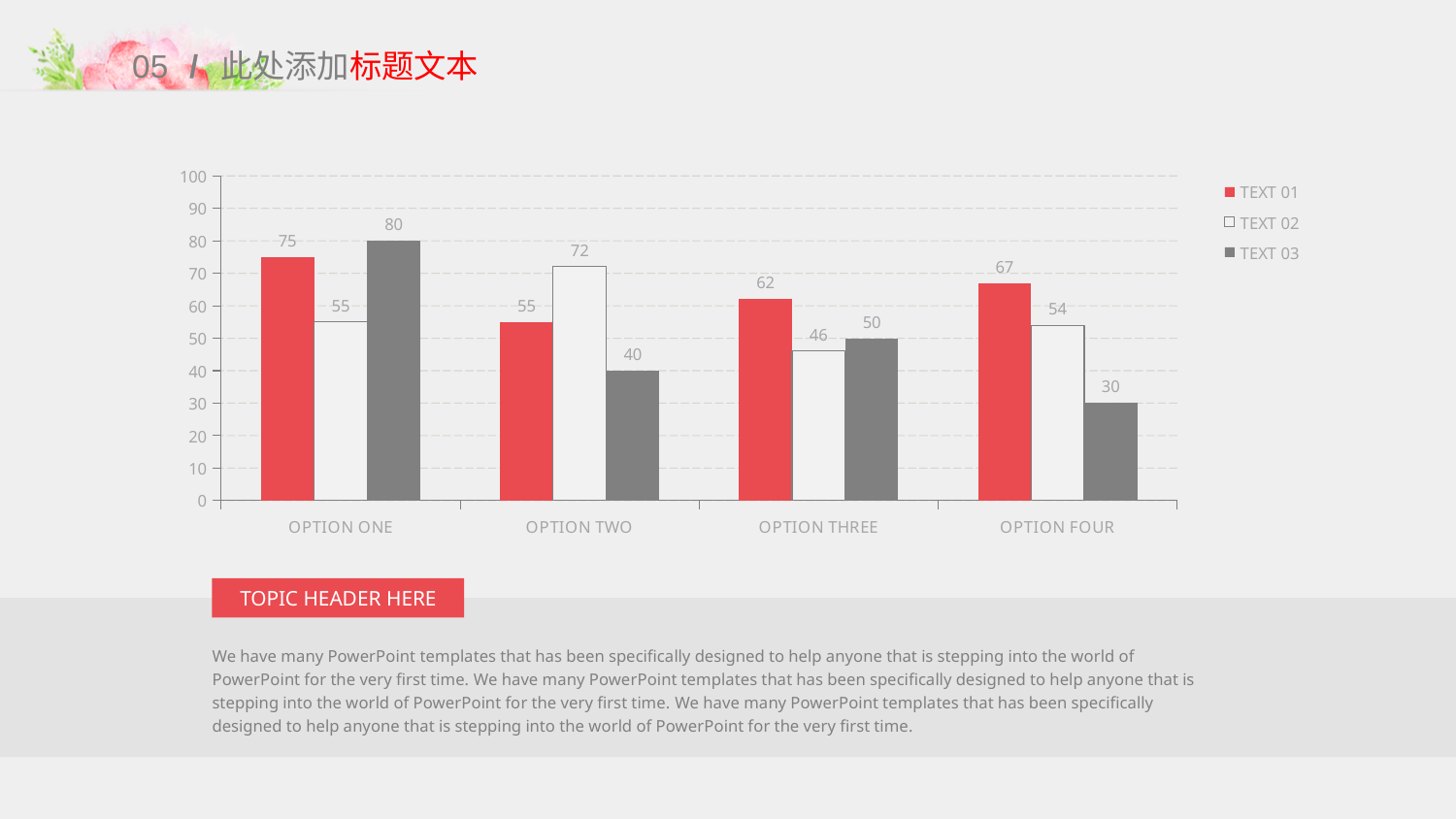
What kind of chart is shown on the slide? bar chart How many series does the legend list? 3 What is the value of TEXT 02 for OPTION TWO? 72 Which category has the lowest TEXT 02 value? OPTION THREE What is the difference between the TEXT 01 and TEXT 03 values for OPTION THREE? 12 Which category has the highest TEXT 03 value? OPTION ONE What is the value of TEXT 03 for OPTION FOUR? 30 Is the TEXT 02 value for OPTION FOUR greater or less than 60? less How many categories are shown on the x axis? 4 Which is larger for OPTION ONE, TEXT 01 or TEXT 03? TEXT 03 What is the value of TEXT 01 for OPTION ONE? 75 What colour are the TEXT 01 bars? red